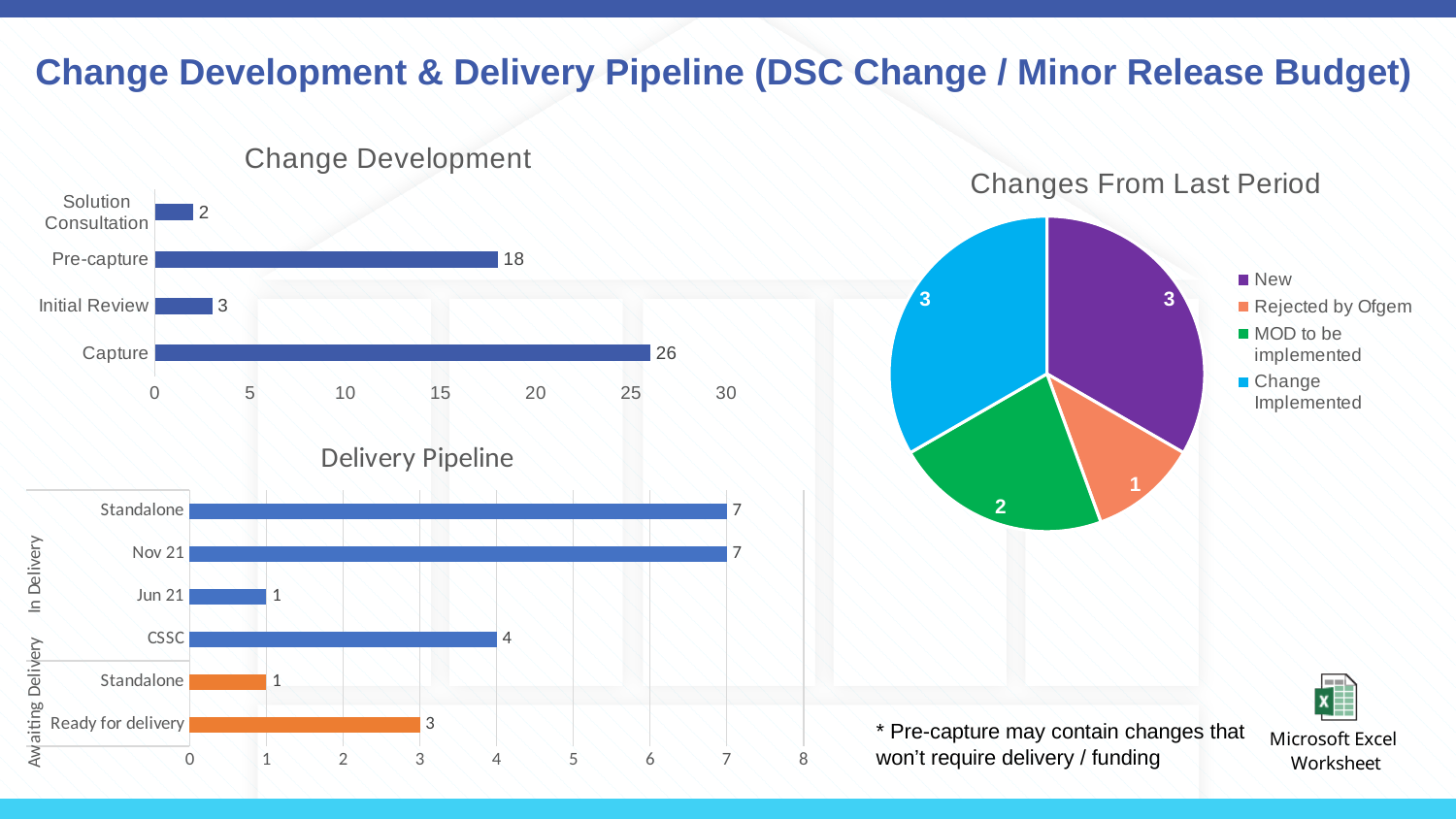
In the Changes From Last Period chart, what is the value for Rejected by Ofgem? 1 What kind of chart is the Changes From Last Period chart? Pie chart In the Delivery Pipeline chart, what is the value for CSSC? 4 In the Change Development chart, what is the value for Pre-capture? 18 In the Delivery Pipeline chart, what is the value for Ready for delivery under Awaiting Delivery? 3 How many entries does the legend of the Changes From Last Period chart list? 4 In the Change Development chart, which category has the lowest value? Solution Consultation In the Delivery Pipeline chart, what is the difference between Nov 21 and CSSC? 3 In the Change Development chart, what is the difference between Capture and Pre-capture? 8 In the Delivery Pipeline chart, which is larger, Nov 21 or Jun 21? Nov 21 In the Change Development chart, how many categories are shown? 4 In the Change Development chart, what is the value for Capture? 26